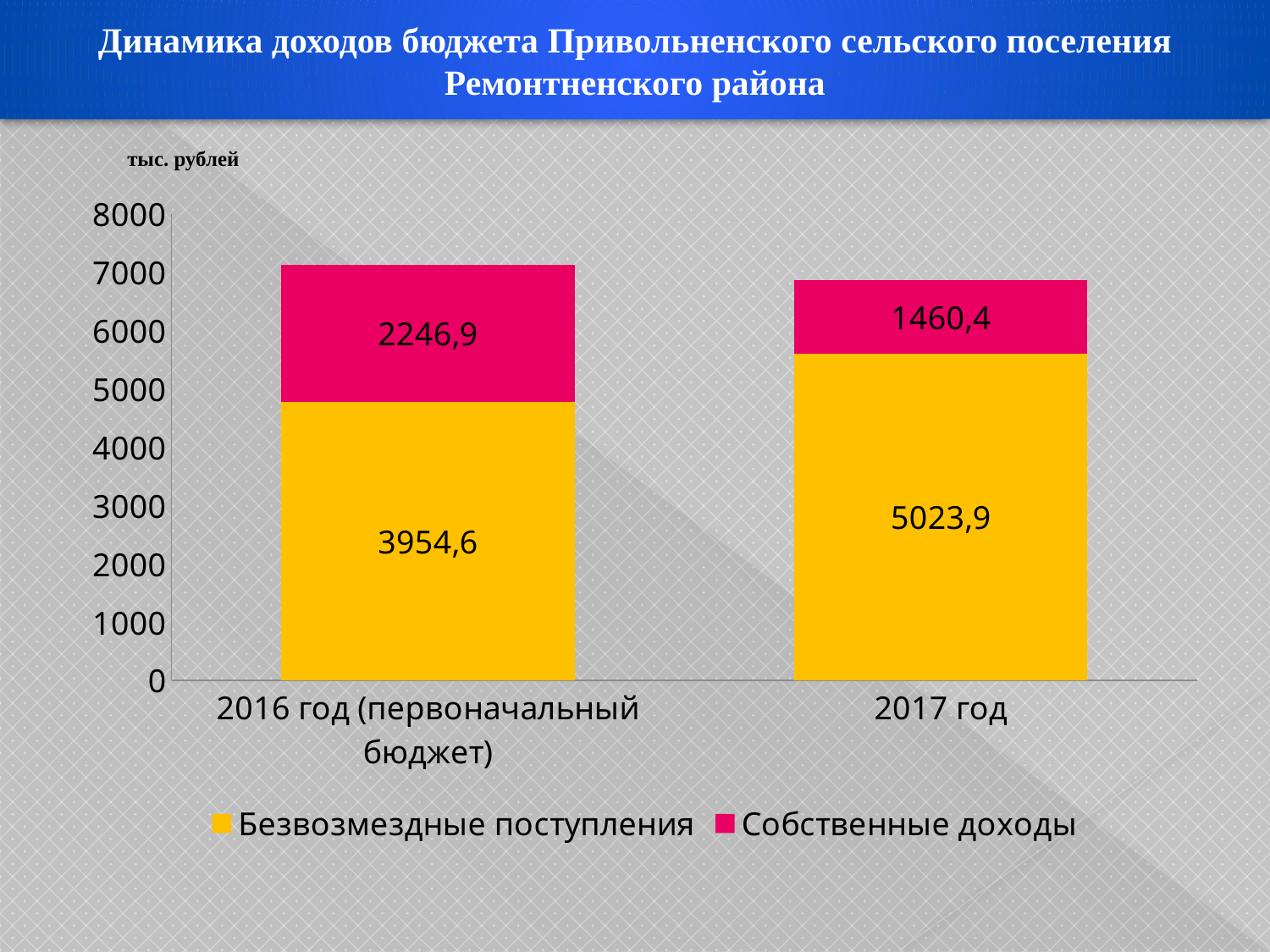
What is the value of Безвозмездные поступления for 2017 год? 5023,9 Do the values for Безвозмездные поступления rise or fall from 2016 to 2017? Rise What type of chart is shown on the slide? Stacked bar chart By how much did Безвозмездные поступления change from 2016 год (первоначальный бюджет) to 2017 год? 1069,3 What is the value of Собственные доходы for 2017 год? 1460,4 What is the difference between Собственные доходы in 2016 год (первоначальный бюджет) and in 2017 год? 786,5 In what units are the values on the chart given? тыс. рублей What is the value of Безвозмездные поступления for 2016 год (первоначальный бюджет)? 3954,6 How many series does the legend list? 2 How many categories (years) are shown on the x axis? 2 What is the value of Собственные доходы for 2016 год (первоначальный бюджет)? 2246,9 Which year has the larger value for Собственные доходы? 2016 год (первоначальный бюджет)